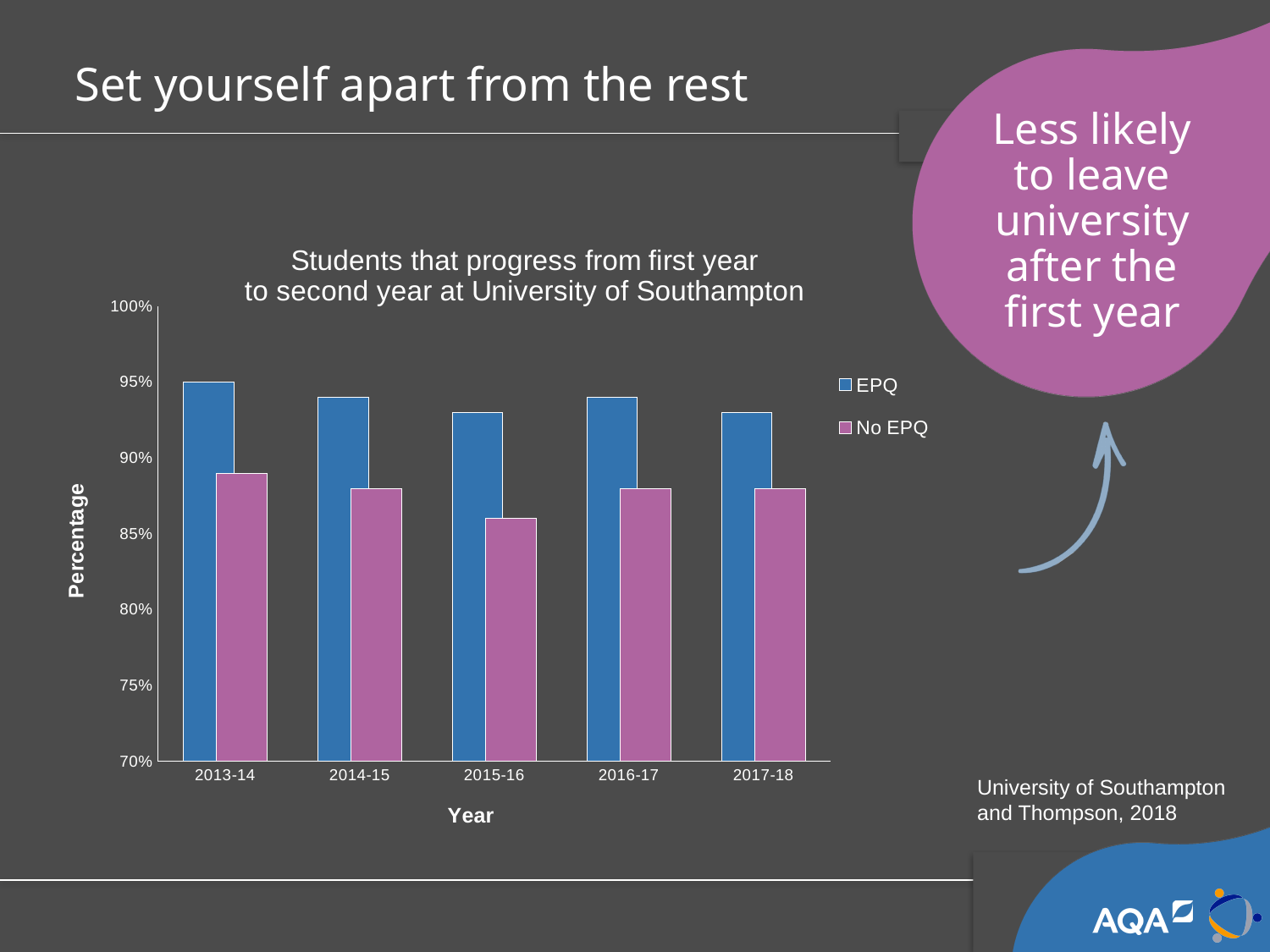
Is the No EPQ value for 2015-16 greater or less than 90%? less Which year has the highest EPQ value? 2013-14 Which year has the lowest No EPQ value? 2015-16 What is the title of the chart? Students that progress from first year to second year at University of Southampton What is the label on the y axis of the chart? Percentage Is the EPQ value for 2017-18 greater or less than 95%? less In 2015-16, which is larger, the EPQ value or the No EPQ value? EPQ How many years are shown on the x axis of the chart? 5 What kind of chart is shown on the slide? bar chart Is the EPQ value for 2013-14 greater or less than 90%? greater How many series does the chart's legend list? 2